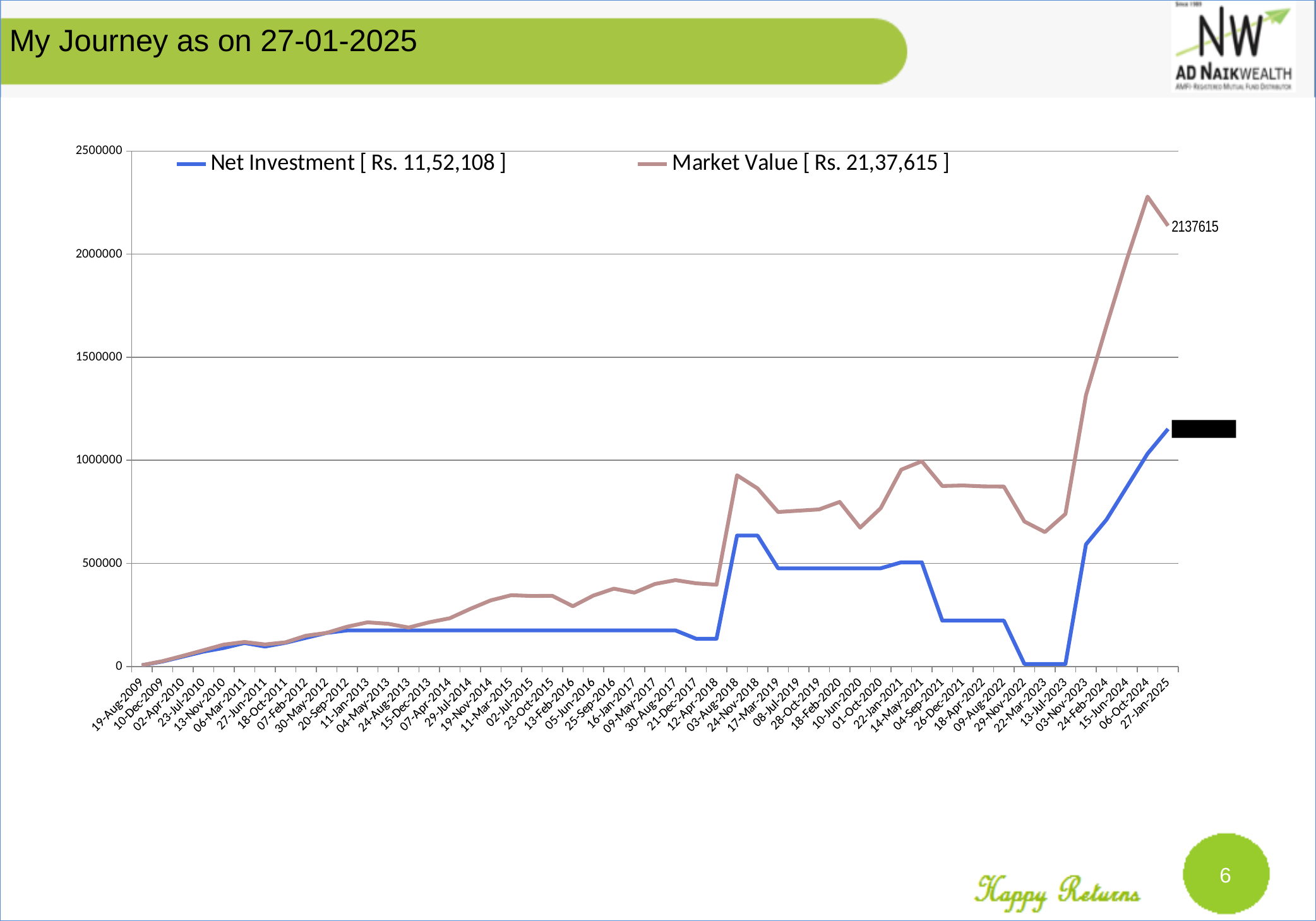
What are the two legend entries of the chart? Net Investment [ Rs. 11,52,108 ] and Market Value [ Rs. 21,37,615 ] Is the Net Investment at 22-Mar-2023 greater or less than 500000? less Which series reaches the highest value on the chart? Market Value At 27-Jan-2025, which series has the larger value, Net Investment or Market Value? Market Value Does the Market Value line rise or fall between 03-Nov-2023 and 06-Oct-2024? rise Is the Net Investment at 27-Jan-2025 greater or less than 1000000? greater Is the Market Value at 03-Aug-2018 greater or less than 1000000? less What is the Market Value plotted at 27-Jan-2025? 2137615 Does the Net Investment line rise or fall between 14-May-2021 and 04-Sep-2021? fall What kind of chart is shown on the slide? line chart How many series does the chart legend list? 2